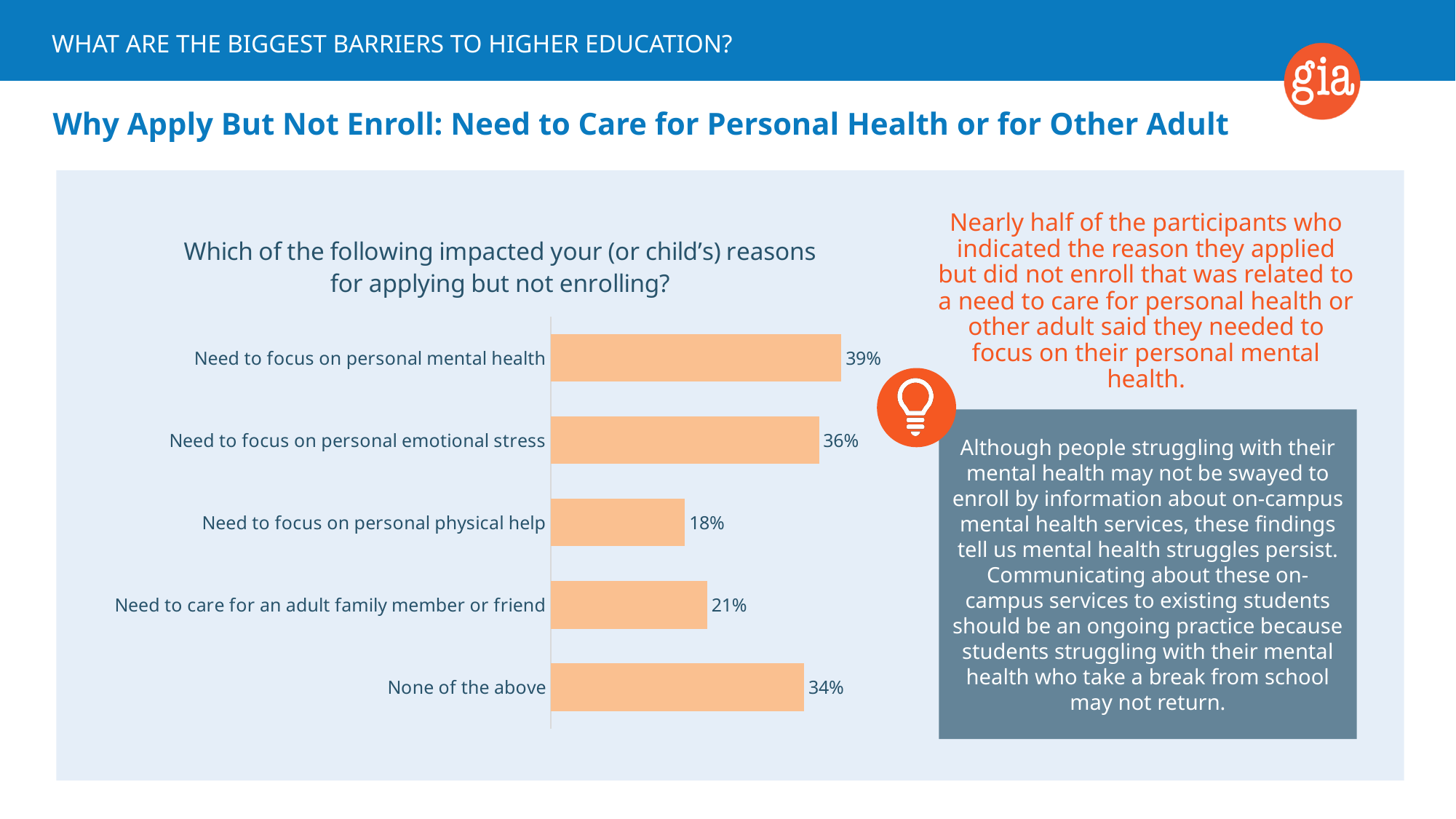
Which category has the lowest value? Need to focus on personal physical help How many categories are shown in the chart? 5 What is the value for "Need to focus on personal physical help"? 18% What is the difference between "Need to focus on personal mental health" and "Need to focus on personal emotional stress"? 3% What percentage of respondents selected "Need to focus on personal mental health"? 39% Which category has the highest value? Need to focus on personal mental health Which is larger: "Need to care for an adult family member or friend" or "Need to focus on personal physical help"? Need to care for an adult family member or friend What is the value for "Need to care for an adult family member or friend"? 21% What type of chart is shown on the slide? Bar chart What question does the chart title ask? Which of the following impacted your (or child's) reasons for applying but not enrolling? What percentage selected "None of the above"? 34% What is the difference between "None of the above" and "Need to focus on personal physical help"? 16%